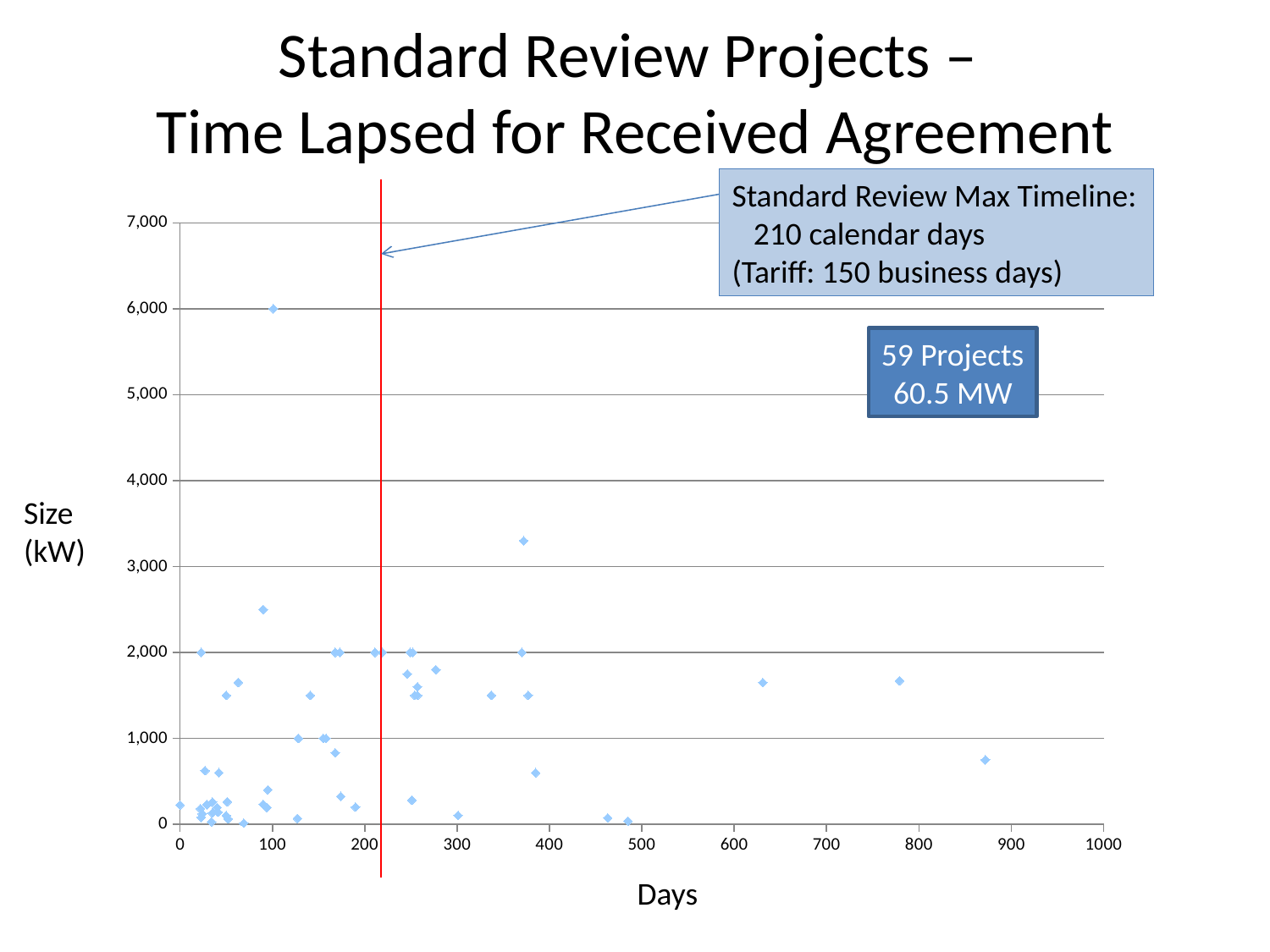
Is the size of the point plotted near 370 days at the upper middle of the chart greater or less than 3,000 kW? greater What is the maximum value shown on the x axis? 1000 What total capacity is stated in the annotation box on the chart? 60.5 MW What is the label of the y axis? Size (kW) How many projects does the chart's annotation box say are plotted? 59 Projects What kind of chart is shown on the slide? scatter chart Is the size of the highest point on the chart greater or less than 5,000 kW? greater Which is larger: the size of the point near 100 days at the top of the chart, or the size of the point near 370 days at about 3,300 kW? the point near 100 days What is the label of the x axis? Days Is the size of the point plotted furthest to the right (near 870 days) greater or less than 1,000 kW? less At how many calendar days is the Standard Review Max Timeline marked by the red vertical line? 210 calendar days What is the size in kW of the highest point on the chart? 6,000